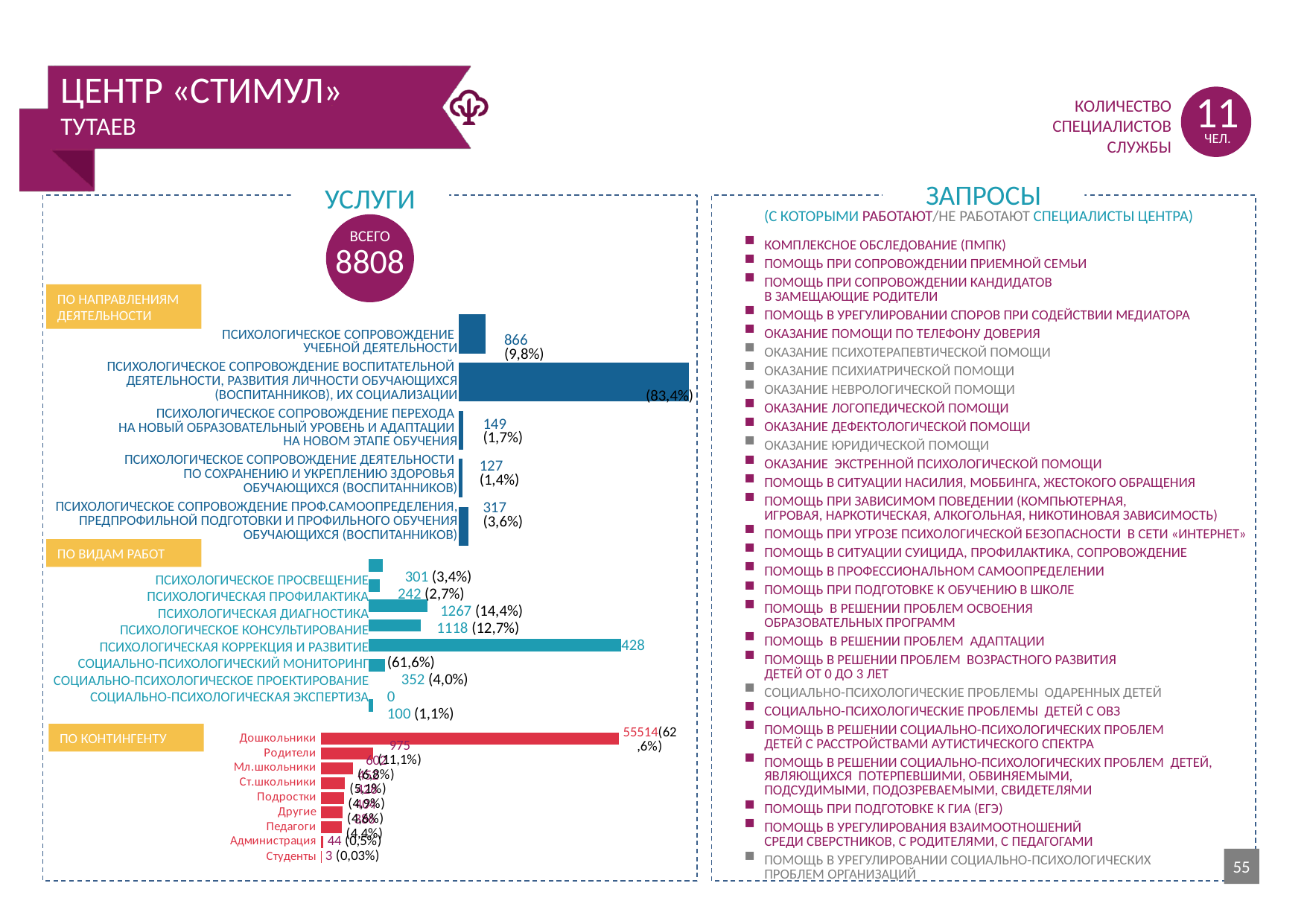
What kind of chart is used in the 'По контингенту' section? Bar chart In the 'По направлениям деятельности' chart, what is the value for 'Психологическое сопровождение проф.самоопределения, предпрофильной подготовки и профильного обучения обучающихся (воспитанников)'? 317 In the 'По видам работ' chart, what percentage is shown for 'Психологическое просвещение'? 3,4% In the 'По направлениям деятельности' chart, how many categories are plotted? 5 In the 'По контингенту' chart, what is the value for 'Студенты'? 3 In the 'По направлениям деятельности' chart, what is the value for 'Психологическое сопровождение учебной деятельности'? 866 In the 'По видам работ' chart, which is larger: 'Психологическая диагностика' or 'Психологическое консультирование'? Психологическая диагностика In the 'По направлениям деятельности' chart, what percentage is shown for 'Психологическое сопровождение воспитательной деятельности, развития личности обучающихся (воспитанников), их социализации'? 83,4% In the 'По видам работ' chart, what is the value for 'Психологическая диагностика'? 1267 In the 'По направлениям деятельности' chart, what is the difference between the values for 'Психологическое сопровождение перехода на новый образовательный уровень' (149) and 'Психологическое сопровождение деятельности по сохранению и укреплению здоровья' (127)? 22 In the 'По направлениям деятельности' chart, which category has the lowest value? Психологическое сопровождение деятельности по сохранению и укреплению здоровья обучающихся (воспитанников) In the 'По контингенту' chart, which category has the highest value? Дошкольники